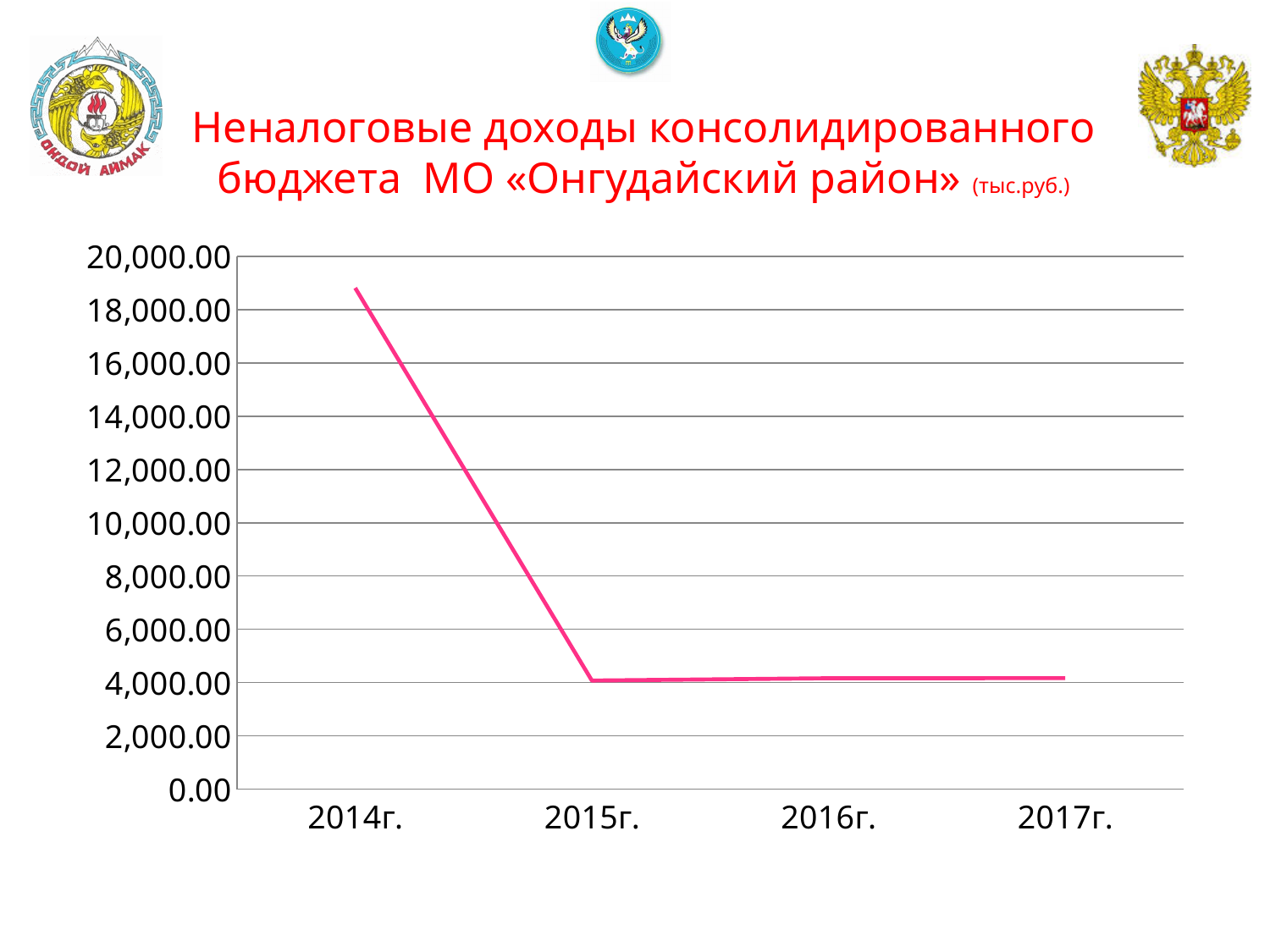
What is the highest value shown on the y axis of the chart? 20,000.00 Which year has the highest value on the chart? 2014г. Is the value for 2014г. greater or less than 18,000.00? greater Is the value for 2017г. greater or less than 2,000.00? greater Is the value for 2016г. greater or less than 8,000.00? less Does the value rise or fall from 2014г. to 2015г.? fall Which is larger, the value for 2014г. or the value for 2015г.? 2014г. What kind of chart is shown on the slide? line chart How many years are plotted on the x axis of the chart? 4 In what units are the values on the chart given, according to the slide title? тыс.руб.